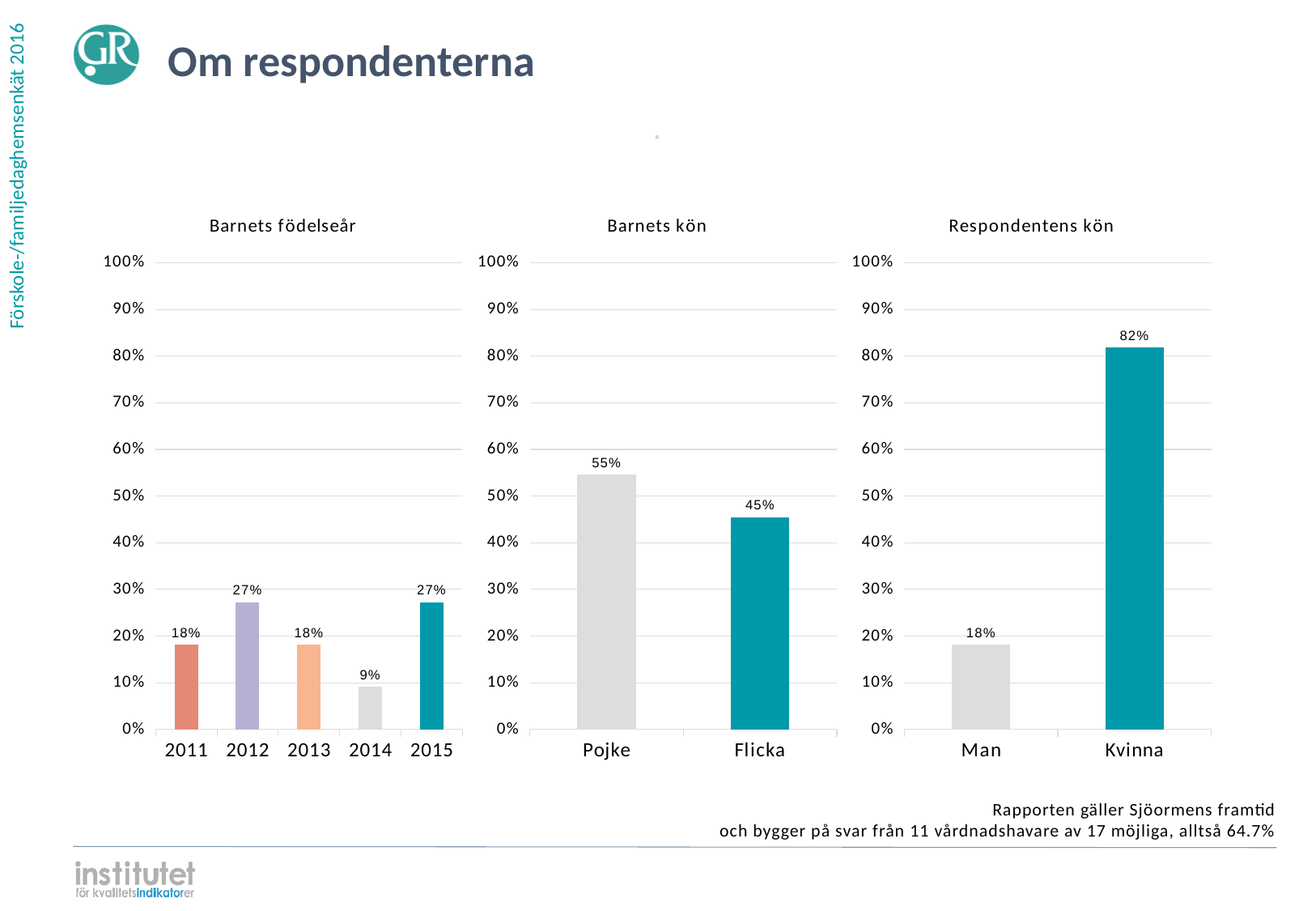
In the 'Barnets kön' chart, what is the difference between Pojke and Flicka? 10% In the 'Barnets kön' chart, which is larger, Pojke or Flicka? Pojke In the 'Barnets födelseår' chart, which birth year has the lowest value? 2014 In the 'Barnets födelseår' chart, what is the difference between the values for 2012 and 2014? 18% What kind of chart is the 'Respondentens kön' chart? Bar chart In the 'Barnets födelseår' chart, how many birth-year categories are shown? 5 In the 'Barnets födelseår' chart, is the value for 2011 greater or less than 20%? less In the 'Barnets kön' chart, what is the value for Pojke? 55% In the 'Barnets födelseår' chart, what is the value for 2014? 9% What is the title of the chart on the left of the slide? Barnets födelseår In the 'Respondentens kön' chart, what is the difference between Kvinna and Man? 64% In the 'Respondentens kön' chart, what is the value for Kvinna? 82%